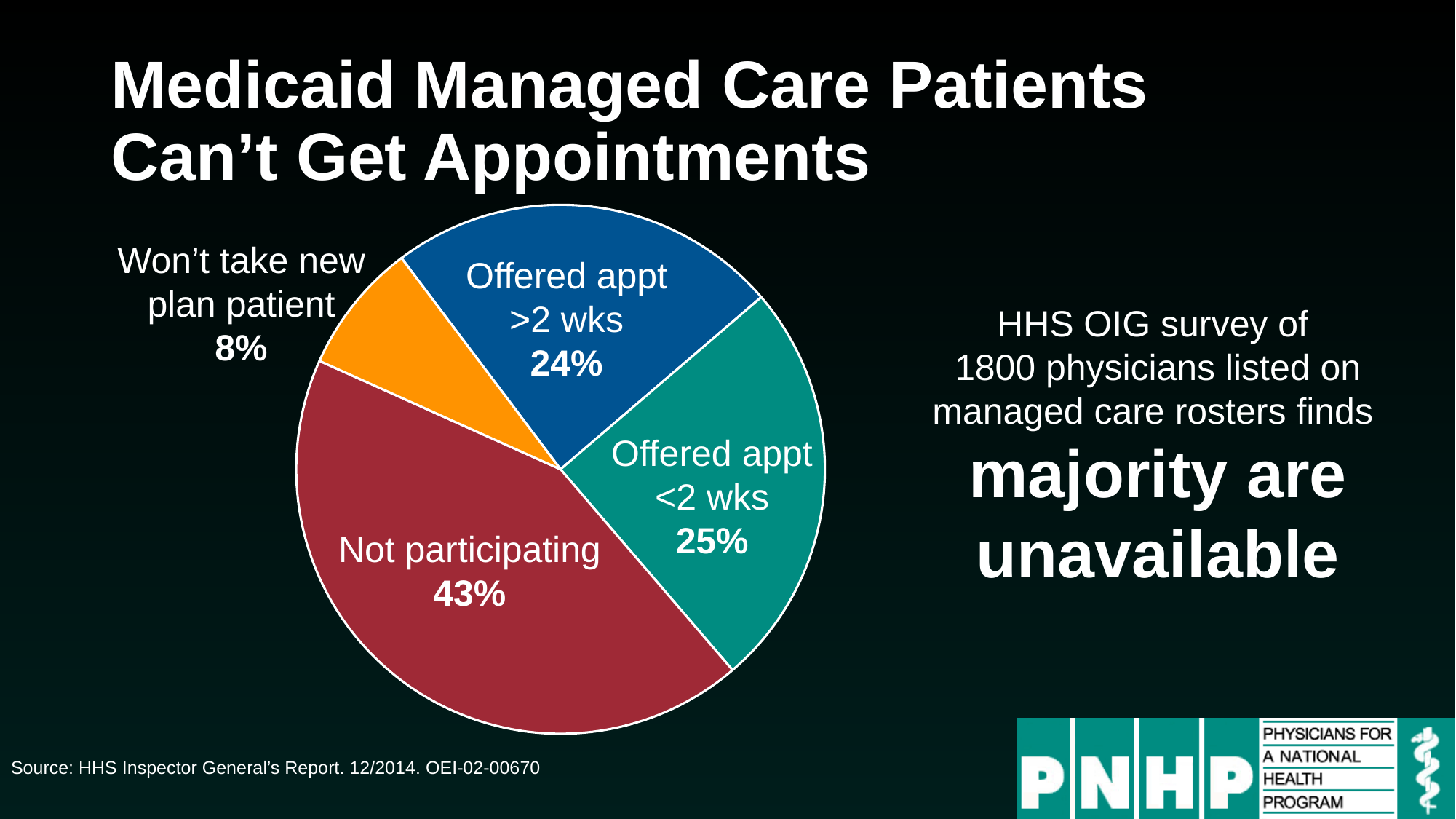
What share of physicians are shown as 'Not participating'? 43% What percentage of physicians offered an appointment in less than 2 weeks? 25% Which slice of the pie is the largest? Not participating What is the combined share of 'Not participating' and 'Won't take new plan patient'? 51% What percentage of physicians offered an appointment in more than 2 weeks? 24% What share of physicians won't take a new plan patient? 8% What is the difference in percentage points between 'Not participating' and 'Offered appt <2 wks'? 18 What colour is the 'Not participating' slice? red How many slices does the pie chart have? 4 Which is larger: 'Offered appt <2 wks' or 'Won't take new plan patient'? Offered appt <2 wks Which slice of the pie is the smallest? Won't take new plan patient What kind of chart is shown on the slide? pie chart